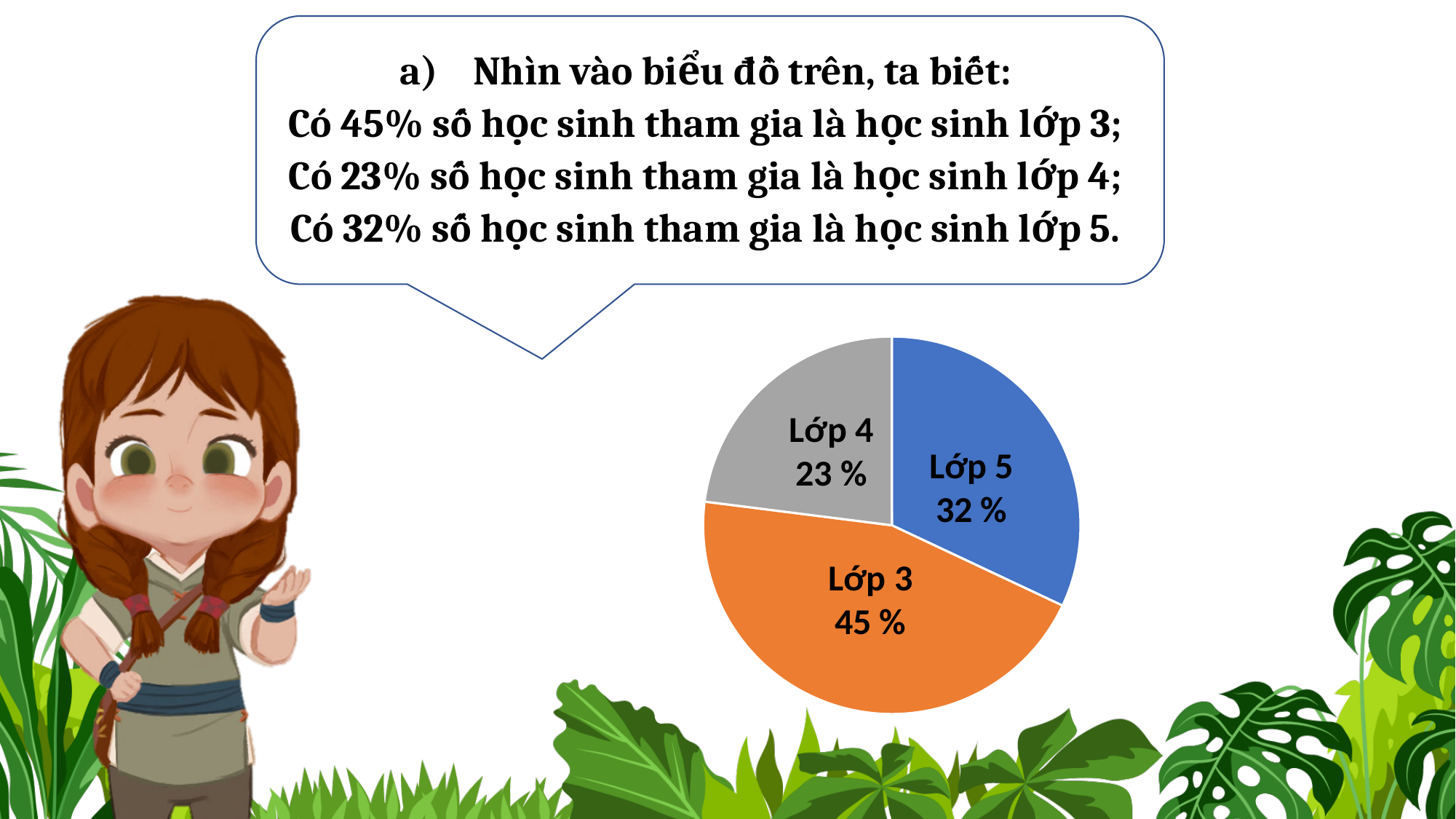
What percentage of the pie chart is Lớp 5? 32 % Which is larger, the slice for Lớp 5 or the slice for Lớp 4? Lớp 5 What kind of chart is shown on the slide? pie chart What colour is the slice for Lớp 5? blue Which class has the smallest slice of the pie chart? Lớp 4 What colour is the slice for Lớp 3? orange How many slices does the pie chart have? 3 What percentage of the pie chart is Lớp 4? 23 % What is the difference in percentage points between Lớp 5 and Lớp 4? 9 What is the difference in percentage points between Lớp 3 and Lớp 4? 22 What percentage of the pie chart is Lớp 3? 45 % Which class has the largest slice of the pie chart? Lớp 3